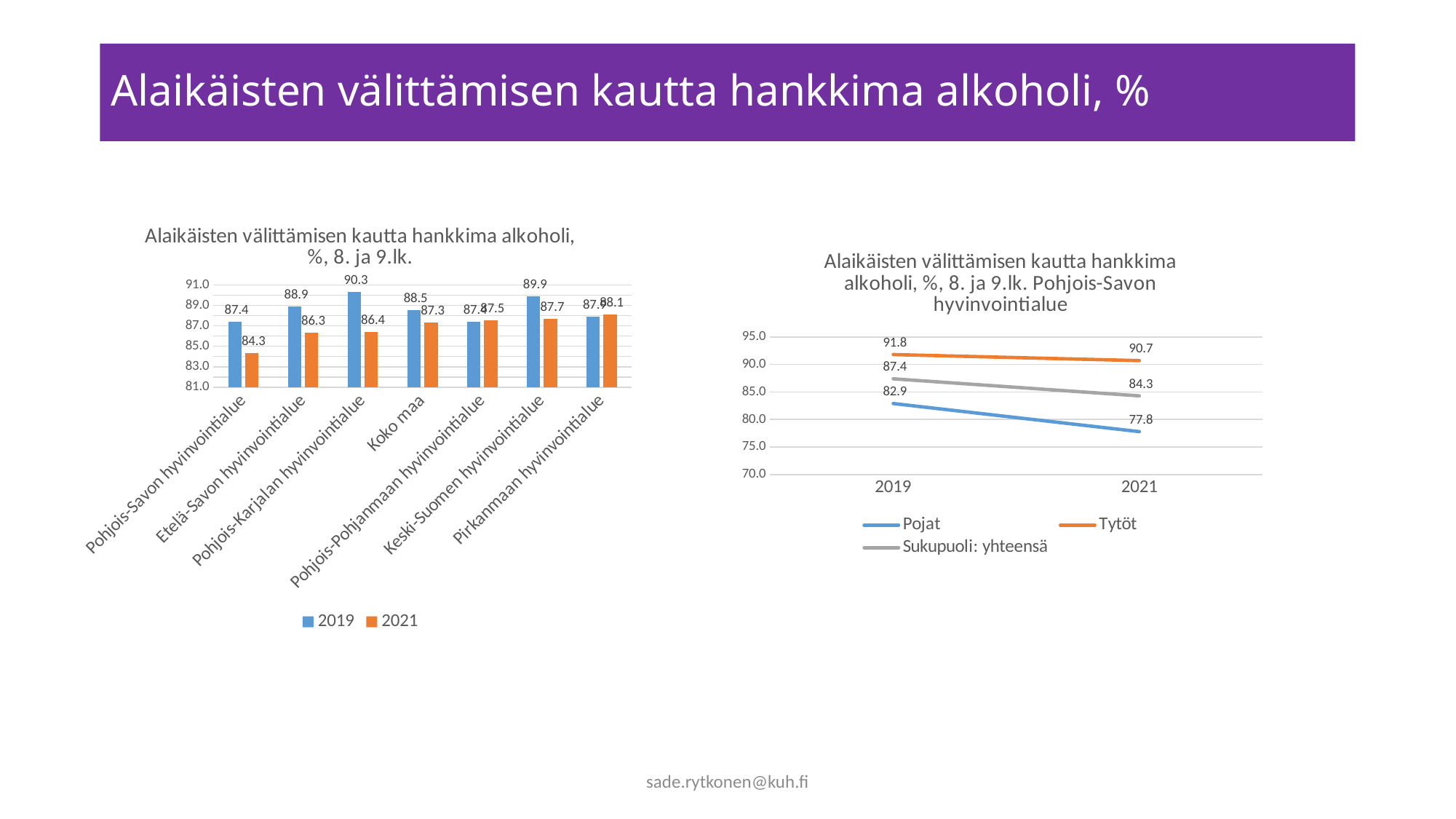
In the left bar chart, how many categories are shown on the x axis? 7 What kind of chart is the right chart about Pohjois-Savon hyvinvointialue? line chart In the left bar chart, which is larger for Koko maa: the 2019 value or the 2021 value? 2019 In the right line chart, what is the value for Pojat in 2021? 77.8 In the left bar chart, what is the 2021 value for Pohjois-Savon hyvinvointialue? 84.3 In the right line chart, does the Tytöt line rise or fall from 2019 to 2021? fall In the left bar chart, which category has the highest 2019 value? Pohjois-Karjalan hyvinvointialue In the left bar chart, how many series does the legend list? 2 In the left bar chart, what is the 2019 value for Pohjois-Karjalan hyvinvointialue? 90.3 What kind of chart is the left chart titled 'Alaikäisten välittämisen kautta hankkima alkoholi, %, 8. ja 9.lk.'? bar chart In the left bar chart, which category has the lowest 2021 value? Pohjois-Savon hyvinvointialue In the left bar chart, what is the difference between the 2019 and 2021 values for Pohjois-Savon hyvinvointialue? 3.1